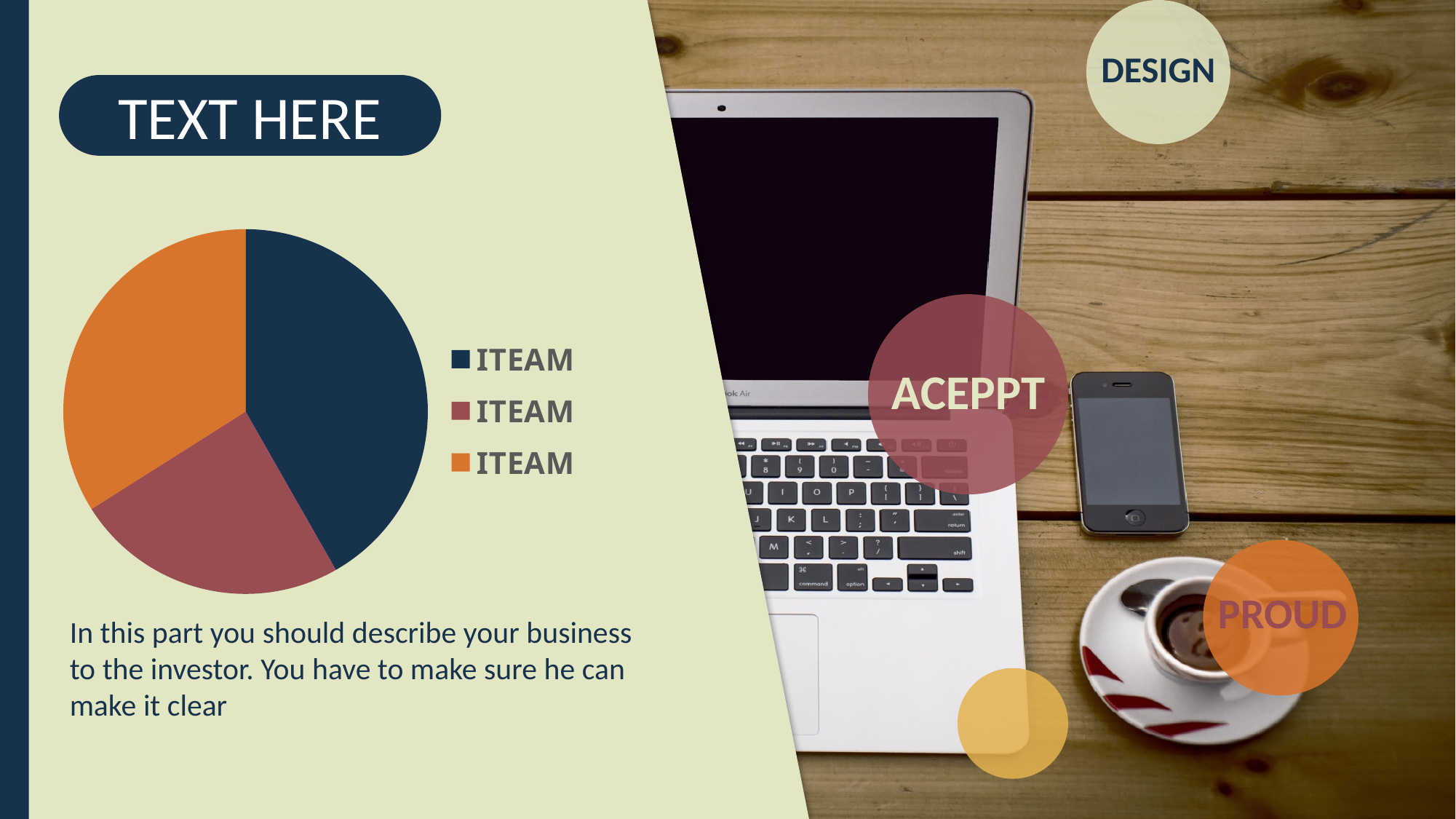
What label is shown for each entry in the pie chart's legend? ITEAM In the pie chart, is the orange slice larger or smaller than the red slice? larger In the pie chart, is the dark blue slice larger or smaller than the orange slice? larger Which colour slice is the largest in the pie chart? dark blue How many slices does the pie chart have? 3 Which colour slice is the smallest in the pie chart? red What kind of chart is shown on the slide? pie chart How many entries does the pie chart's legend list? 3 What colour is the first legend entry of the pie chart? dark blue